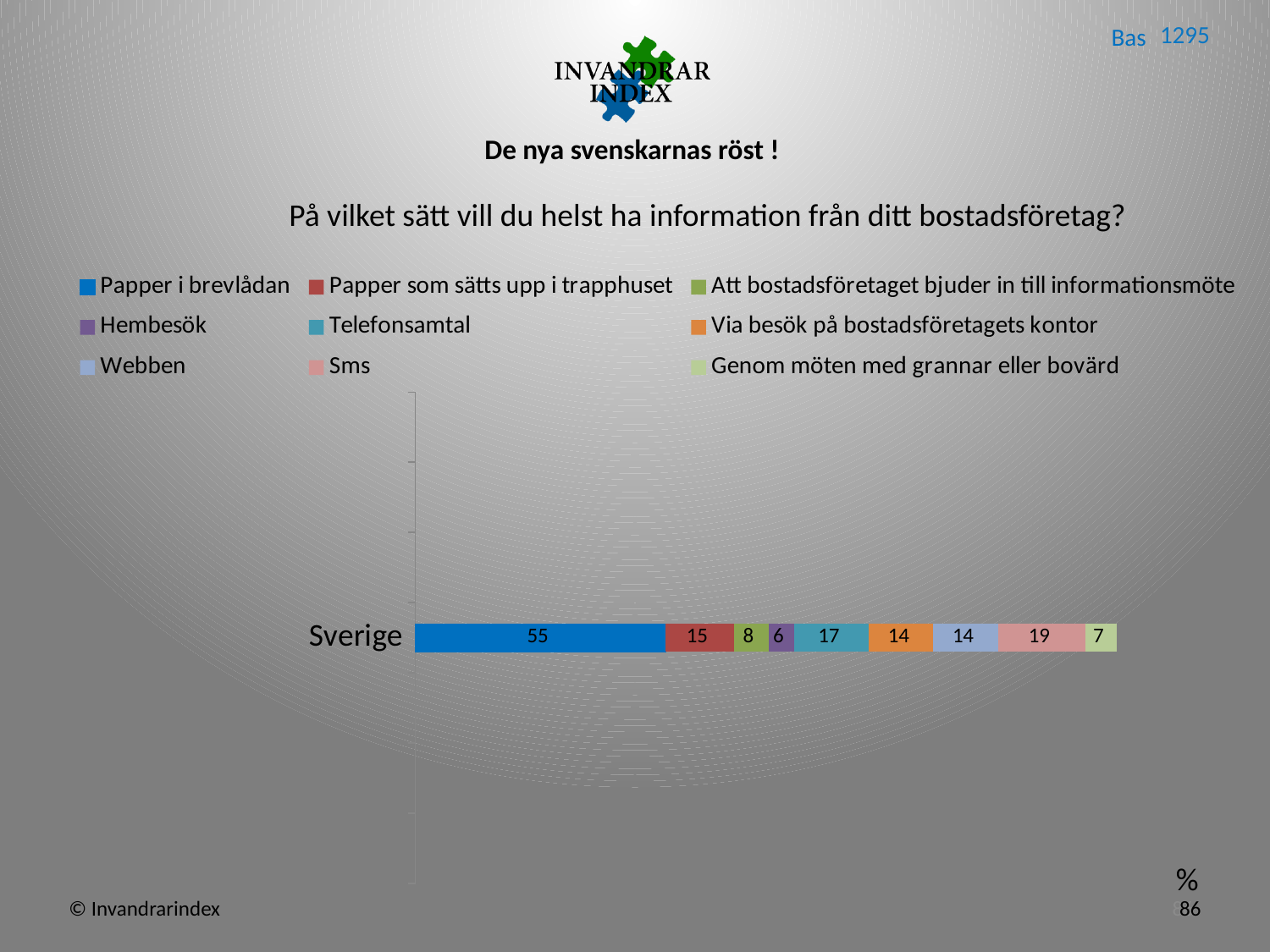
How many series does the legend list? 9 What is the total of the stacked bar for Sverige? 155 What is the value for Sms for Sverige? 19 Which series has the lowest value for Sverige? Hembesök Which series has the highest value for Sverige? Papper i brevlådan Which is larger for Sverige, Sms or Telefonsamtal? Sms What is the value for Papper i brevlådan for Sverige? 55 What kind of chart is shown on the slide? Stacked bar chart What is the difference between Papper i brevlådan and Papper som sätts upp i trapphuset for Sverige? 40 What is the value for Hembesök for Sverige? 6 What is the value for Telefonsamtal for Sverige? 17 Which series is shown in the legend with a purple marker? Hembesök